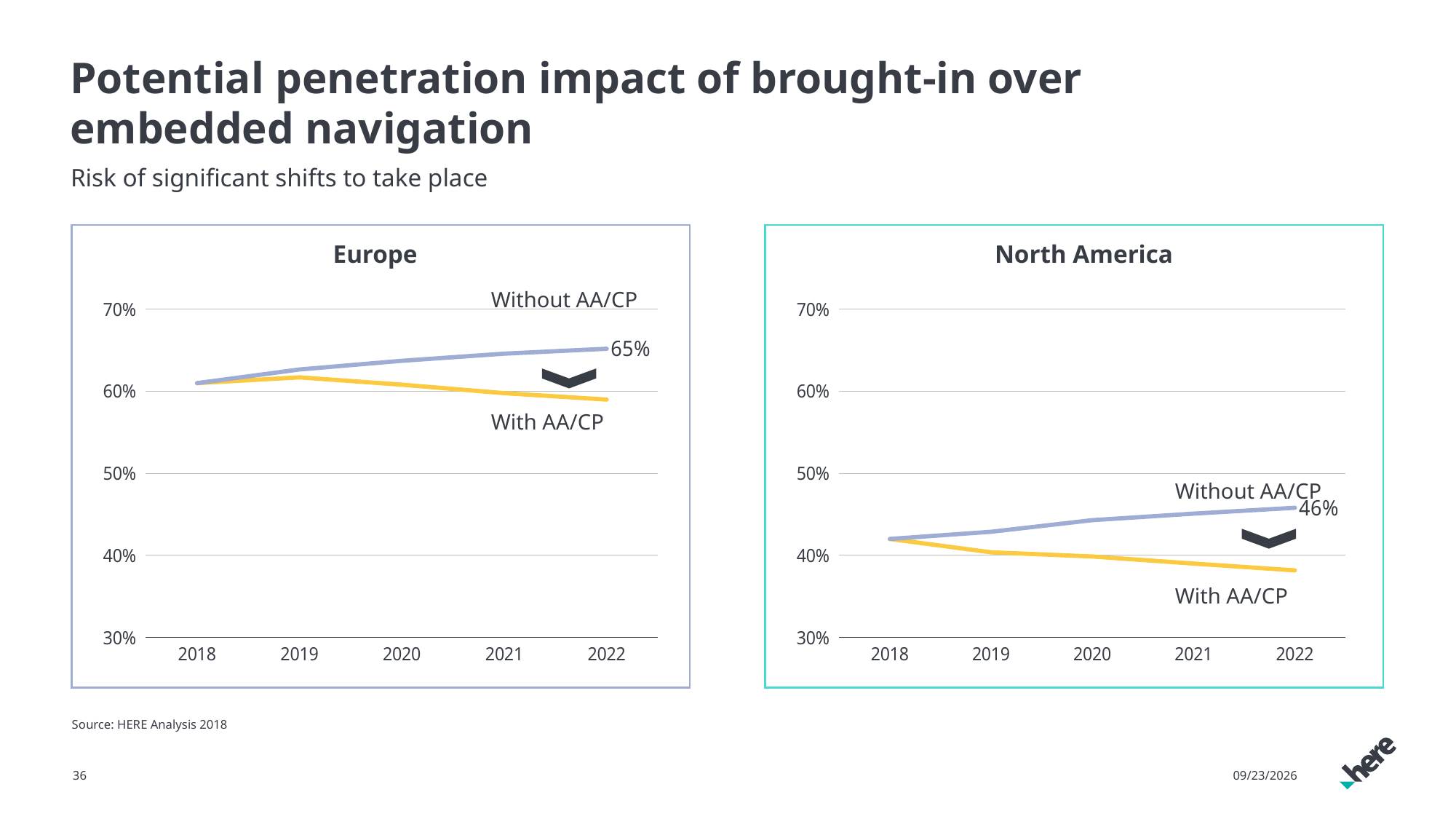
In the Europe chart, does the Without AA/CP line rise or fall from 2018 to 2022? Rise In the North America chart, what is the value of the Without AA/CP line in 2022? 46% How many series are plotted in the Europe chart? 2 In the Europe chart, which series has the higher value in 2022, Without AA/CP or With AA/CP? Without AA/CP In the North America chart, is the 2022 value for With AA/CP greater or less than 40%? less How much higher is the 2022 Without AA/CP value in the Europe chart than in the North America chart? 19 percentage points What is the title of the chart on the right side of the slide? North America What kind of chart is the Europe chart? Line chart In the North America chart, does the With AA/CP line rise or fall from 2018 to 2022? Fall In the Europe chart, is the 2022 value for With AA/CP greater or less than 60%? less How many years are shown on the x axis of the North America chart? 5 In the Europe chart, what is the value of the Without AA/CP line in 2022? 65%